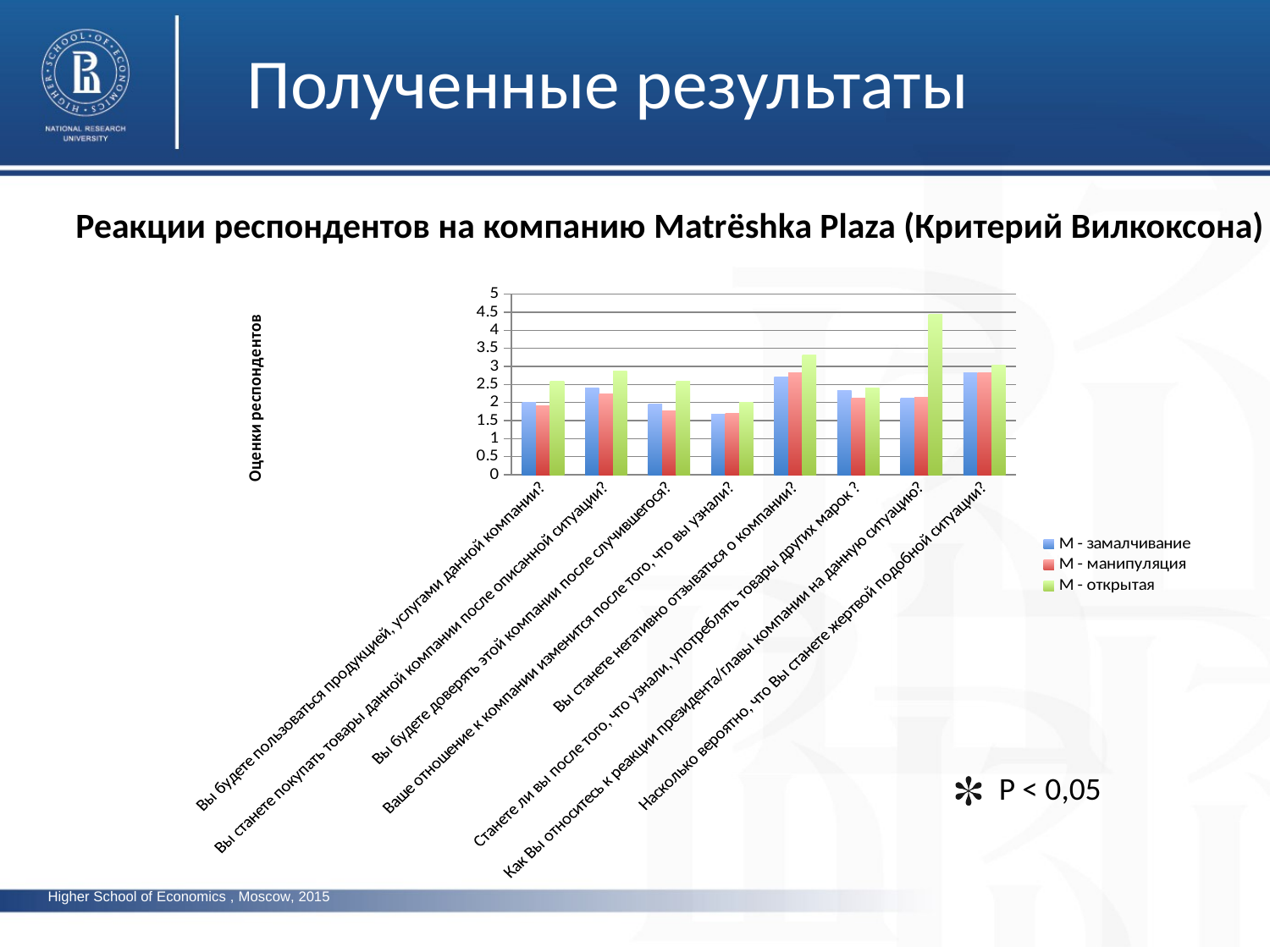
Is the value of 'М - замалчивание' for 'Ваше отношение к компании изменится после того, что вы узнали?' greater or less than 2? less For which category does the series 'М - замалчивание' have its lowest value? Ваше отношение к компании изменится после того, что вы узнали? How many question categories are plotted along the x axis of the chart? 8 What is the title of the chart? Реакции респондентов на компанию Matrëshka Plaza (Критерий Вилкоксона) How many series does the chart legend list? 3 For 'Как Вы относитесь к реакции президента/главы компании на данную ситуацию?', which series has the larger value: 'М - открытая' or 'М - замалчивание'? М - открытая Is the value of 'М - открытая' for 'Насколько вероятно, что Вы станете жертвой подобной ситуации?' greater or less than 4? less For which category does the series 'М - открытая' reach its highest value? Как Вы относитесь к реакции президента/главы компании на данную ситуацию? What kind of chart is shown on the slide? bar chart Is the value of 'М - открытая' for 'Вы станете негативно отзываться о компании?' greater or less than 3? greater For 'Вы будете доверять этой компании после случившегося?', which series has the larger value: 'М - открытая' or 'М - манипуляция'? М - открытая What is the label of the vertical axis of the chart? Оценки респондентов